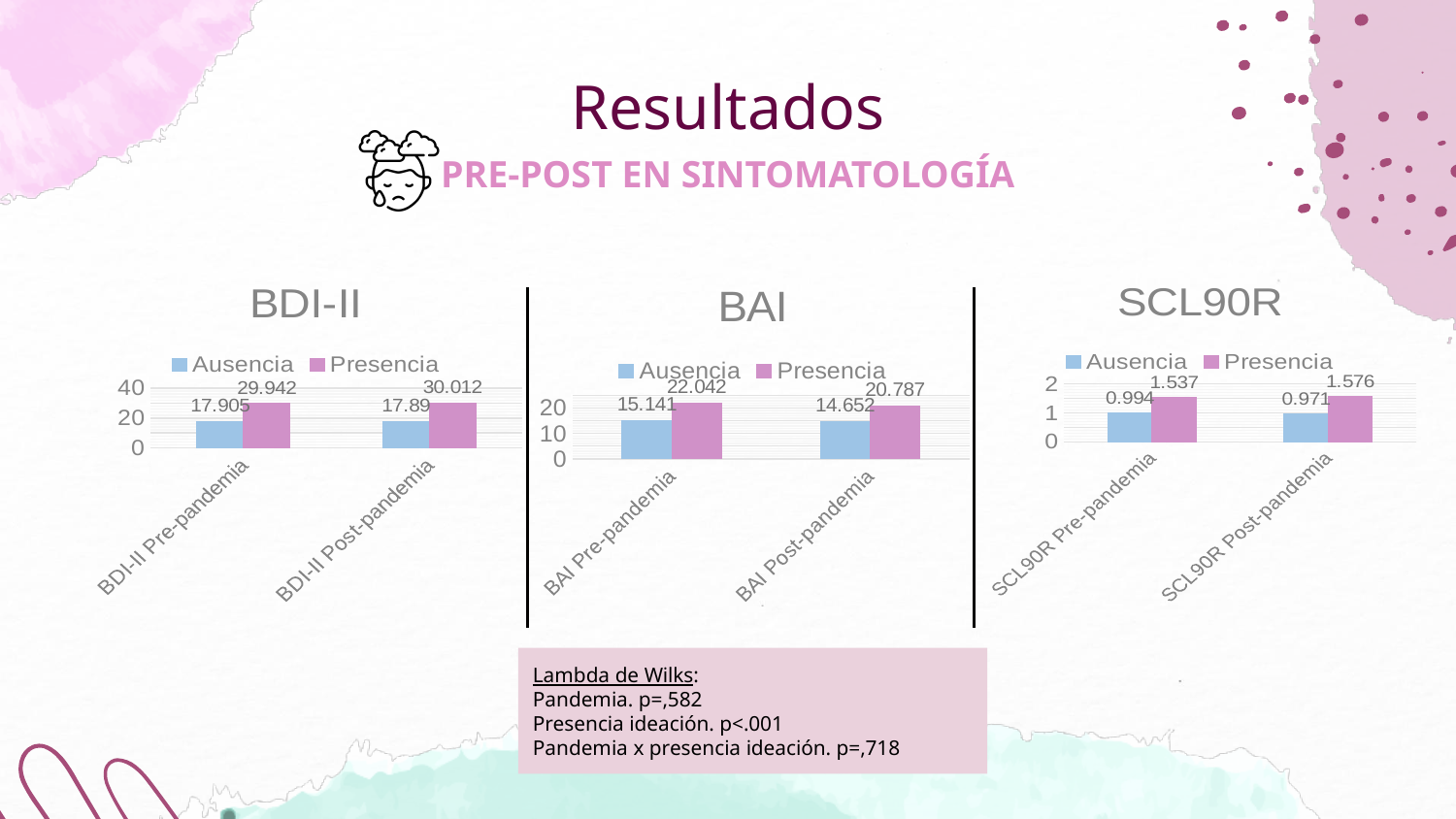
In the BAI chart, what is the difference between Presencia and Ausencia at BAI Pre-pandemia? 6.901 In the BDI-II chart, what is the value for Presencia at BDI-II Pre-pandemia? 29.942 In the SCL90R chart, what is the value for Presencia at SCL90R Post-pandemia? 1.576 In the SCL90R chart, is the value for Presencia at SCL90R Pre-pandemia greater or less than 1? greater In the BAI chart, does the Ausencia value rise or fall from BAI Pre-pandemia to BAI Post-pandemia? fall In the BDI-II chart, what is the value for Ausencia at BDI-II Post-pandemia? 17.89 In the SCL90R chart, what is the value for Ausencia at SCL90R Pre-pandemia? 0.994 What kind of chart is the SCL90R chart? bar chart In the BAI chart, what is the value for Ausencia at BAI Pre-pandemia? 15.141 In the BDI-II chart, which is larger at BDI-II Post-pandemia, Ausencia or Presencia? Presencia How many series does the legend of the BAI chart list? 2 In the BAI chart, what is the value for Presencia at BAI Post-pandemia? 20.787